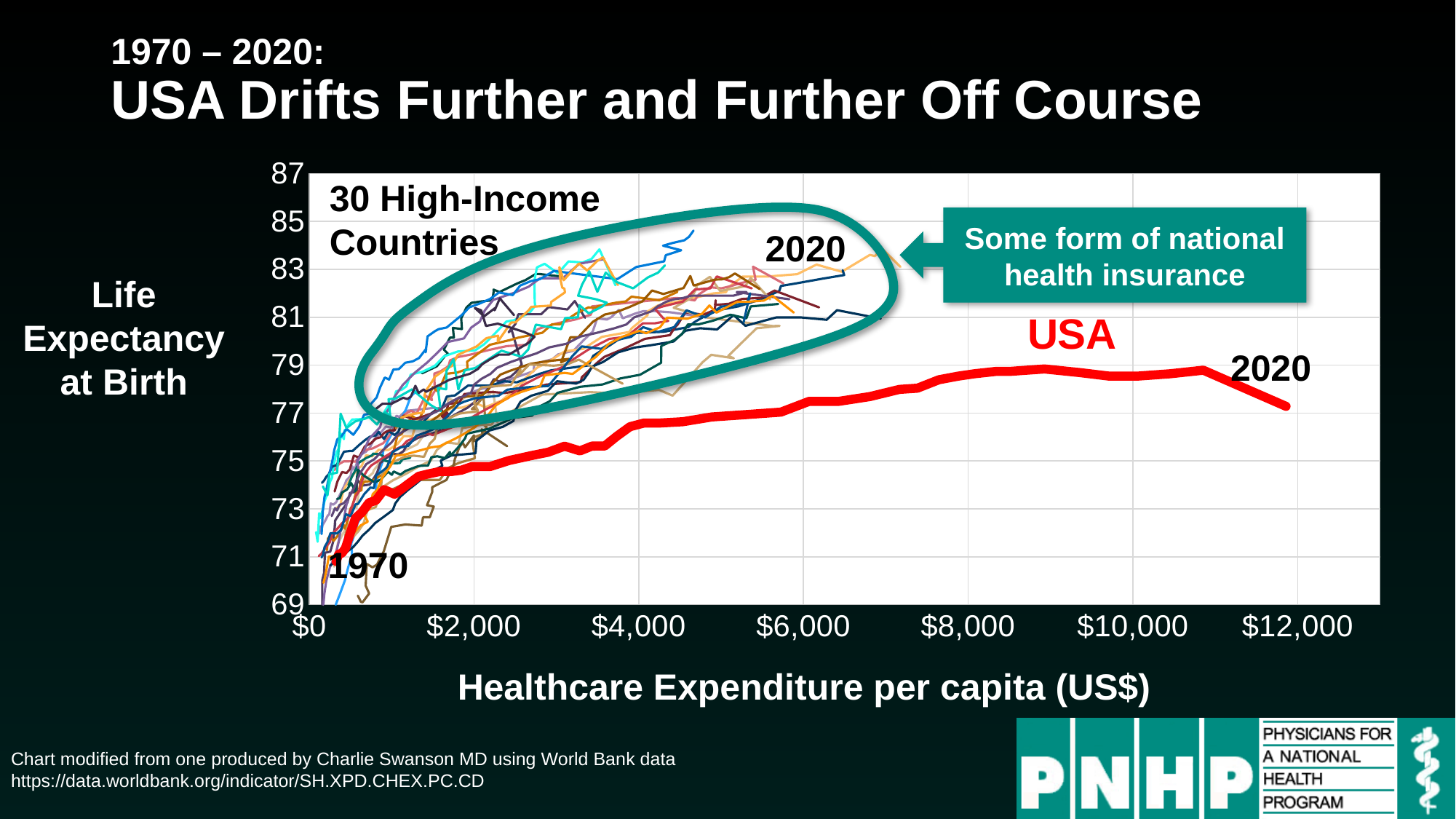
Is the USA's healthcare expenditure per capita at its 2020 endpoint greater or less than $10,000? greater In 2020, which spends more on healthcare per capita: the USA or the 30 high-income countries? USA What kind of chart is shown on the slide? Line chart Is the USA's life expectancy at its 1970 starting point greater or less than 73? less In 2020, which has the higher life expectancy: the USA or the 30 high-income countries? The 30 high-income countries Does the USA line's life expectancy rise or fall at its far right end, approaching 2020? fall Is the USA's life expectancy at its 2020 endpoint greater or less than 79? less What does the horizontal axis of the chart measure? Healthcare Expenditure per capita (US$) Which country is represented by the thick red line? USA How many high-income countries are plotted alongside the USA? 30 What is the highest value labelled on the horizontal axis? $12,000 Overall from 1970 to 2020, does the USA's life expectancy rise or fall? rise